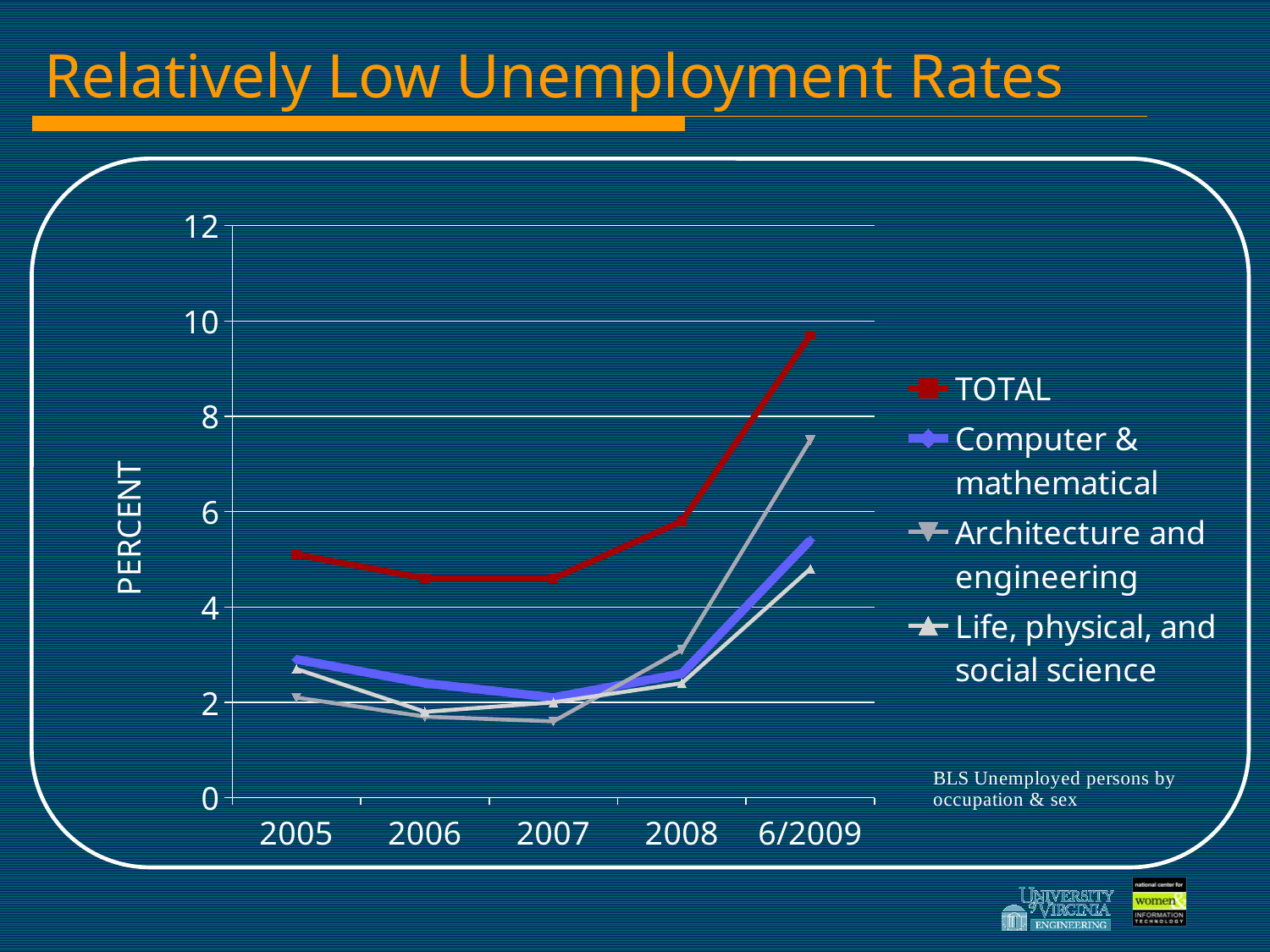
How many series does the legend list? 4 Is the value for Architecture and engineering at 6/2009 greater or less than 6? greater Which series has the lowest value in 2007? Architecture and engineering Which series has the highest value at 6/2009? TOTAL Is the value for Architecture and engineering in 2007 greater or less than 2? less Does the TOTAL series rise or fall from 2007 to 6/2009? Rise How many time points are shown on the x axis? 5 Which series has the lowest value at 6/2009? Life, physical, and social science Is the value for TOTAL at 6/2009 greater or less than 8? greater What kind of chart is shown on the slide? Line chart What is the label on the y axis? PERCENT In 2008, which is larger: the value for TOTAL or the value for Architecture and engineering? TOTAL